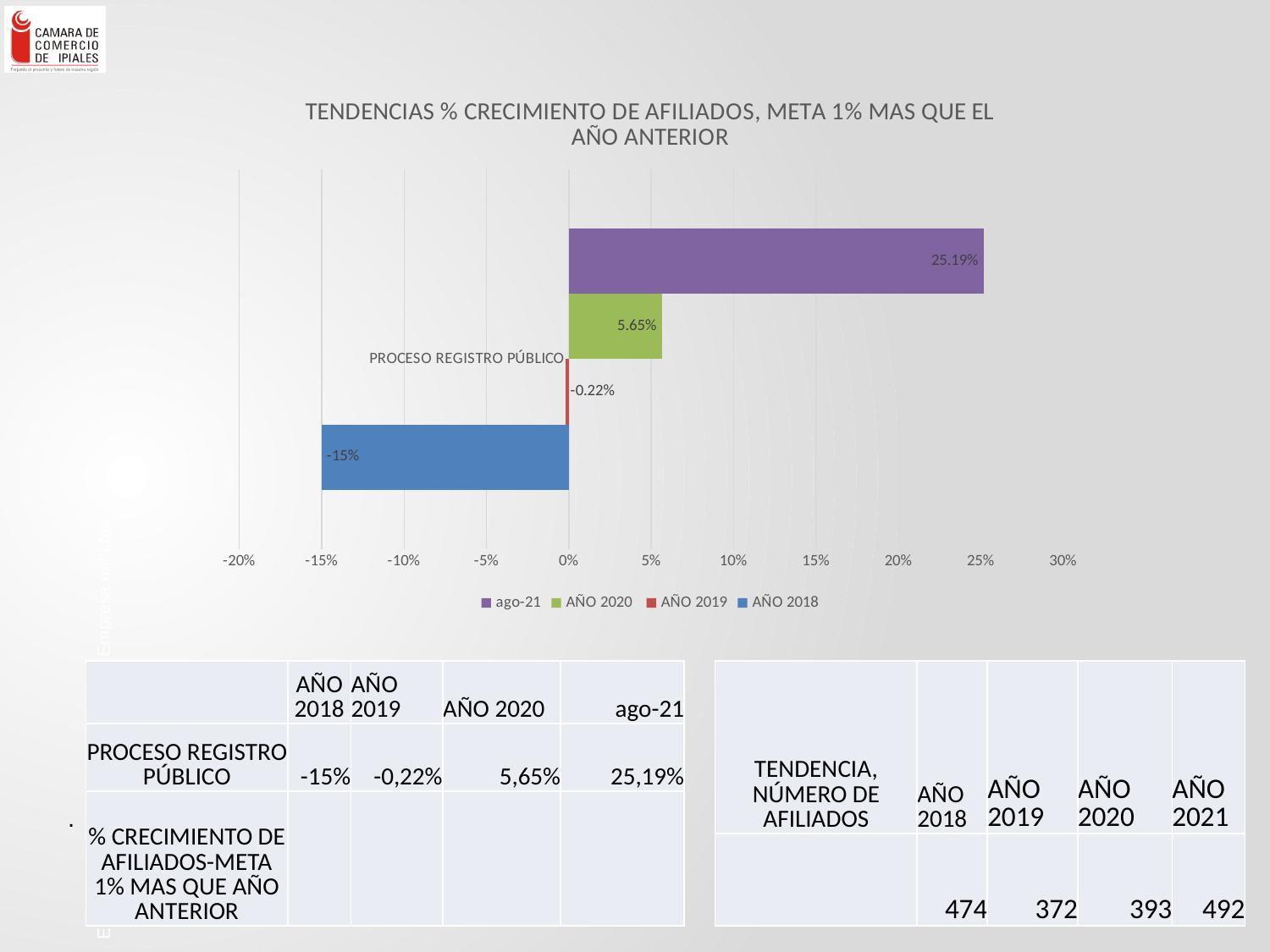
What is the difference between the ago-21 value and the AÑO 2020 value? 19.54% How many series does the legend list? 4 What is the value for the AÑO 2018 series in the chart? -15% Is the value for ago-21 greater or less than 20%? greater What is the value for the AÑO 2019 series in the chart? -0.22% Which is larger, the value for AÑO 2020 or the value for AÑO 2019? AÑO 2020 What is the title of the chart? TENDENCIAS % CRECIMIENTO DE AFILIADOS, META 1% MAS QUE EL AÑO ANTERIOR Which series has the lowest value in the chart? AÑO 2018 What is the value for the AÑO 2020 series in the chart? 5.65% Which series has the highest value in the chart? ago-21 What kind of chart is shown on the slide? Bar chart What is the value for the ago-21 series in the chart? 25.19%